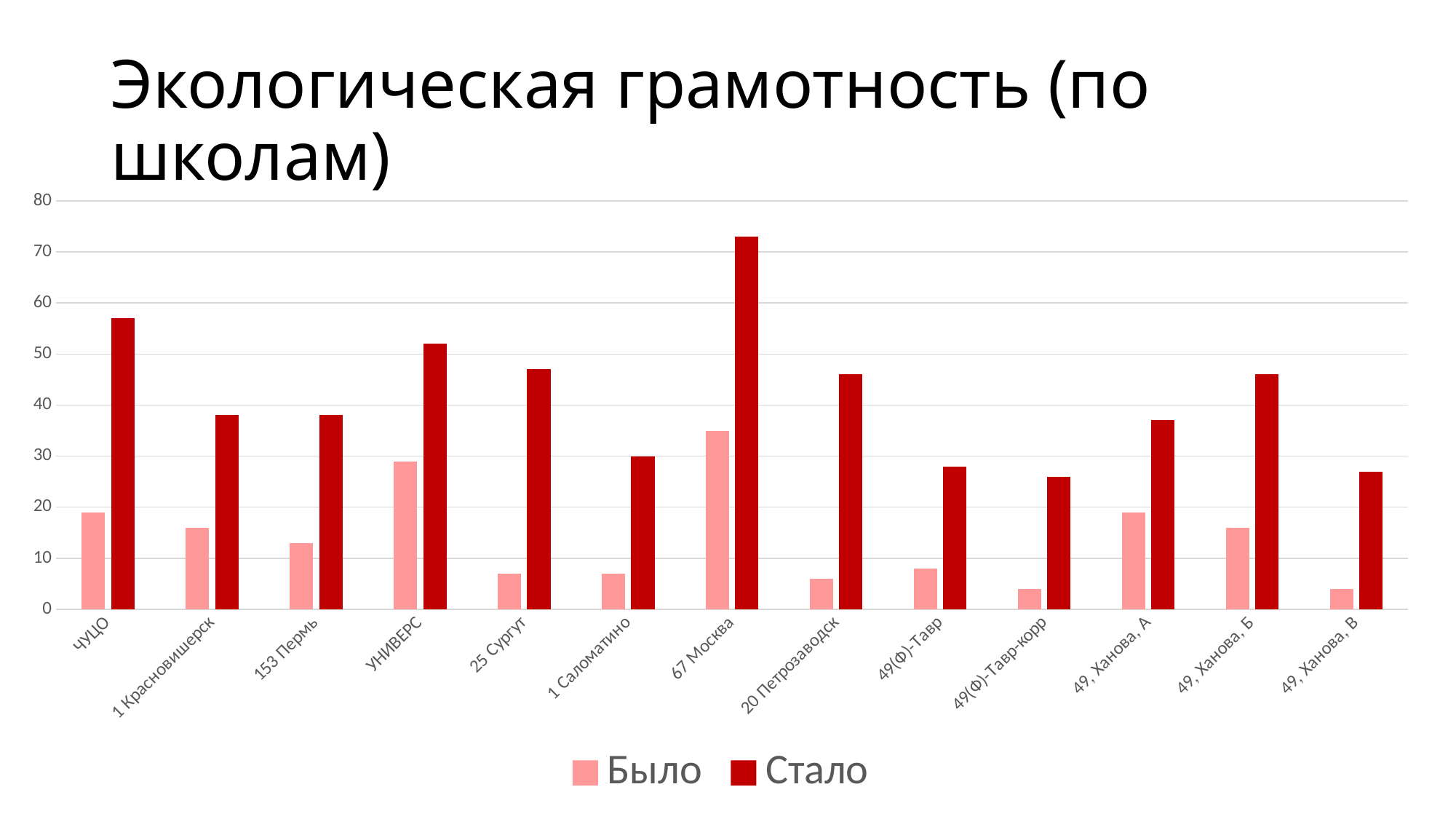
Is the "Было" value for 25 Сургут greater or less than 10? less Which school has the highest value for the "Стало" series? 67 Москва Which school has the larger "Стало" value: 25 Сургут or 1 Саломатино? 25 Сургут How many schools (categories) are shown on the x axis? 13 Which school has the highest value for the "Было" series? 67 Москва Which is larger for УНИВЕРС: the "Было" value or the "Стало" value? Стало Is the "Стало" value for 67 Москва greater or less than 70? greater What is the title of the chart? Экологическая грамотность (по школам) What kind of chart is shown on the slide? bar chart How many series does the legend list? 2 Is the "Стало" value for ЧУЦО greater or less than 50? greater